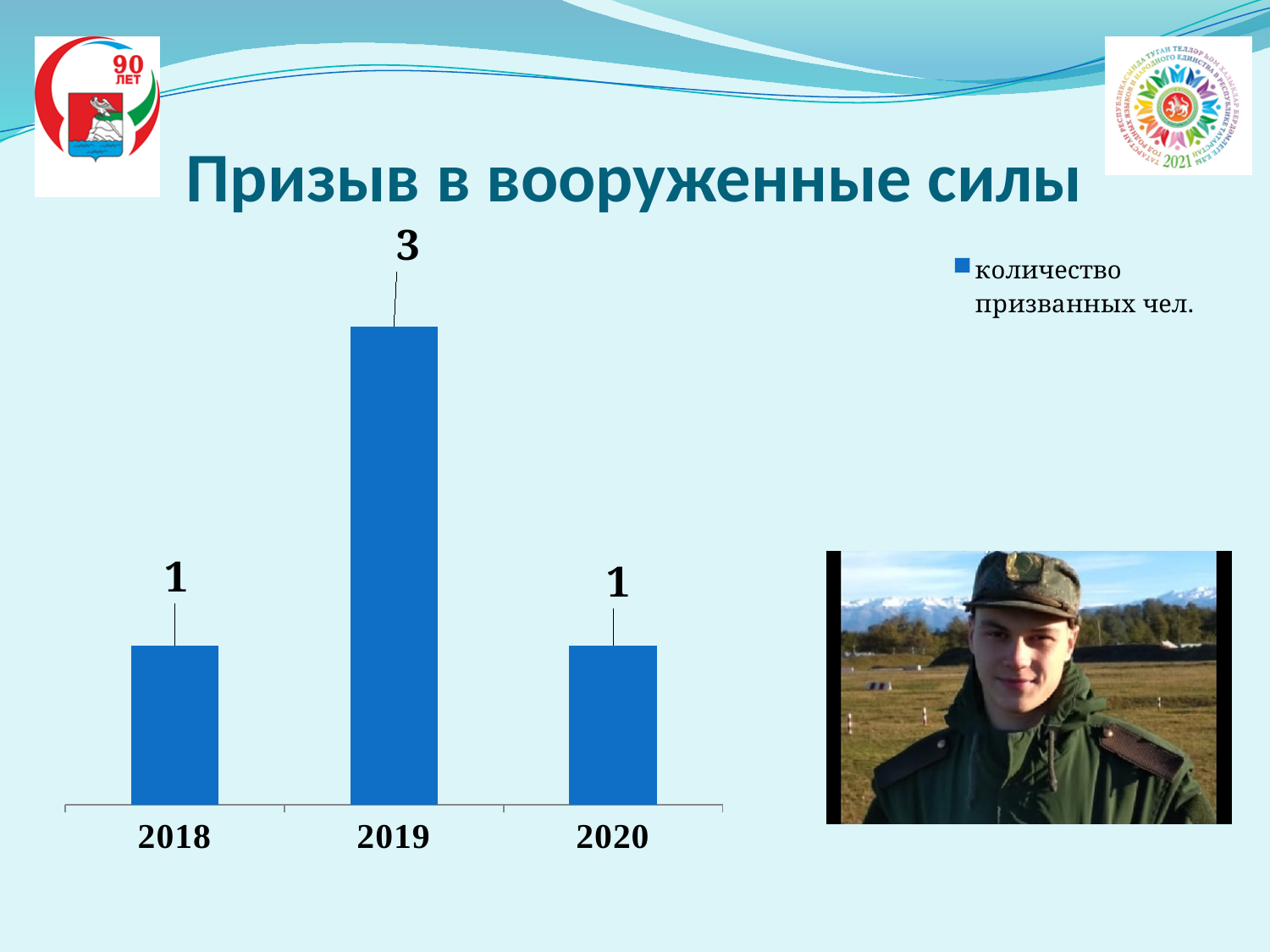
What is the value for 2019? 3 Which is larger, the value for 2019 or the value for 2020? 2019 What is the value for 2020? 1 What is the difference between the values for 2019 and 2018? 2 Does the value rise or fall from 2019 to 2020? fall How many series does the legend list? 1 What kind of chart is shown on the slide? bar chart What is the value for 2018? 1 How many years are shown on the x axis? 3 Which year has the highest value? 2019 What is the legend entry for the series? количество призванных чел. What is the title of the slide above the chart? Призыв в вооруженные силы